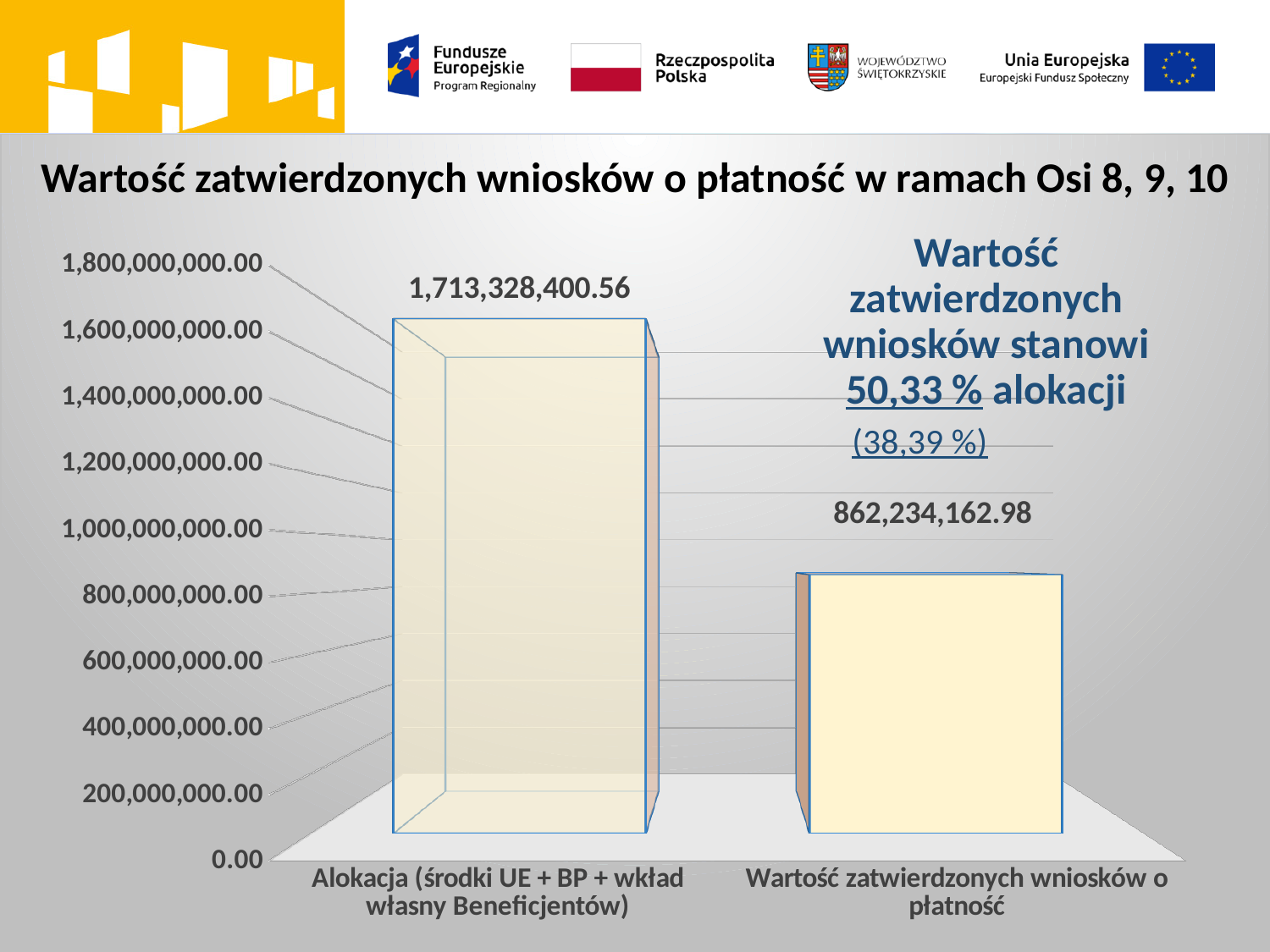
How many categories are shown in the chart? 2 According to the text next to the chart, what percentage of the allocation do the approved payment applications represent? 50,33 % Is the value for "Alokacja (środki UE + BP + wkład własny Beneficjentów)" greater or less than 1,600,000,000.00? greater What kind of chart is shown on the slide? bar chart Which category has the highest value in the chart? Alokacja (środki UE + BP + wkład własny Beneficjentów) Which category has the lowest value in the chart? Wartość zatwierdzonych wniosków o płatność What is the value of the bar for "Wartość zatwierdzonych wniosków o płatność"? 862,234,162.98 Which is larger: the value for "Alokacja (środki UE + BP + wkład własny Beneficjentów)" or the value for "Wartość zatwierdzonych wniosków o płatność"? Alokacja (środki UE + BP + wkład własny Beneficjentów) What is the difference between the value for "Alokacja (środki UE + BP + wkład własny Beneficjentów)" and the value for "Wartość zatwierdzonych wniosków o płatność"? 851,094,237.58 Is the value for "Wartość zatwierdzonych wniosków o płatność" greater or less than 1,000,000,000.00? less What is the title of the chart on the slide? Wartość zatwierdzonych wniosków o płatność w ramach Osi 8, 9, 10 What is the value of the bar for "Alokacja (środki UE + BP + wkład własny Beneficjentów)"? 1,713,328,400.56